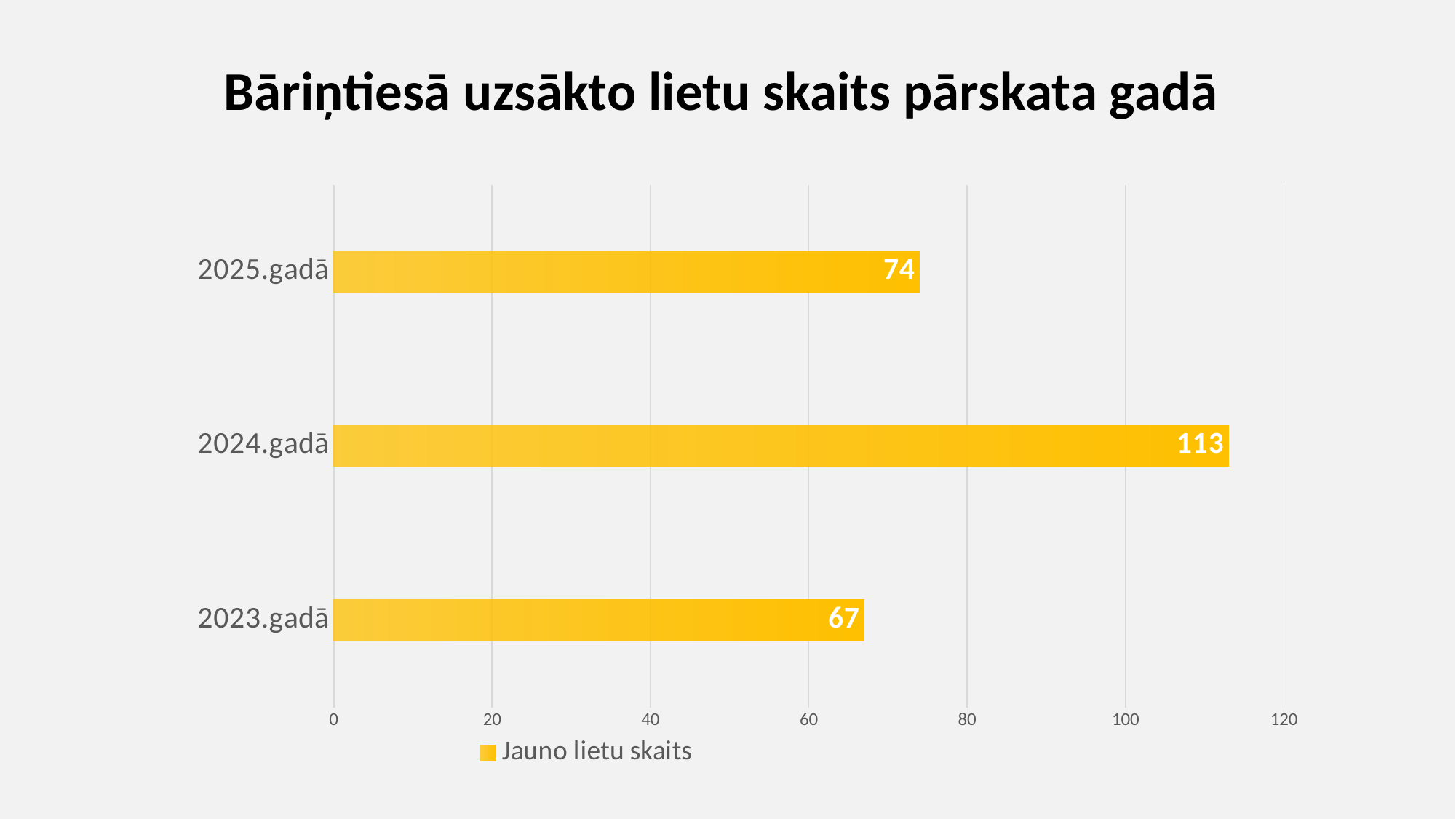
What is the difference between the values for 2025.gadā and 2023.gadā? 7 What is the value for 2025.gadā? 74 What is the difference between the values for 2024.gadā and 2025.gadā? 39 How many categories are shown in the chart? 3 Which is larger, the value for 2024.gadā or the value for 2023.gadā? 2024.gadā What is the value for 2024.gadā? 113 What is the title of the chart? Bāriņtiesā uzsākto lietu skaits pārskata gadā What is the value for 2023.gadā? 67 Is the value for 2024.gadā greater or less than 100? greater What kind of chart is shown on the slide? bar chart Which year has the highest number of new cases? 2024.gadā Which year has the lowest number of new cases? 2023.gadā